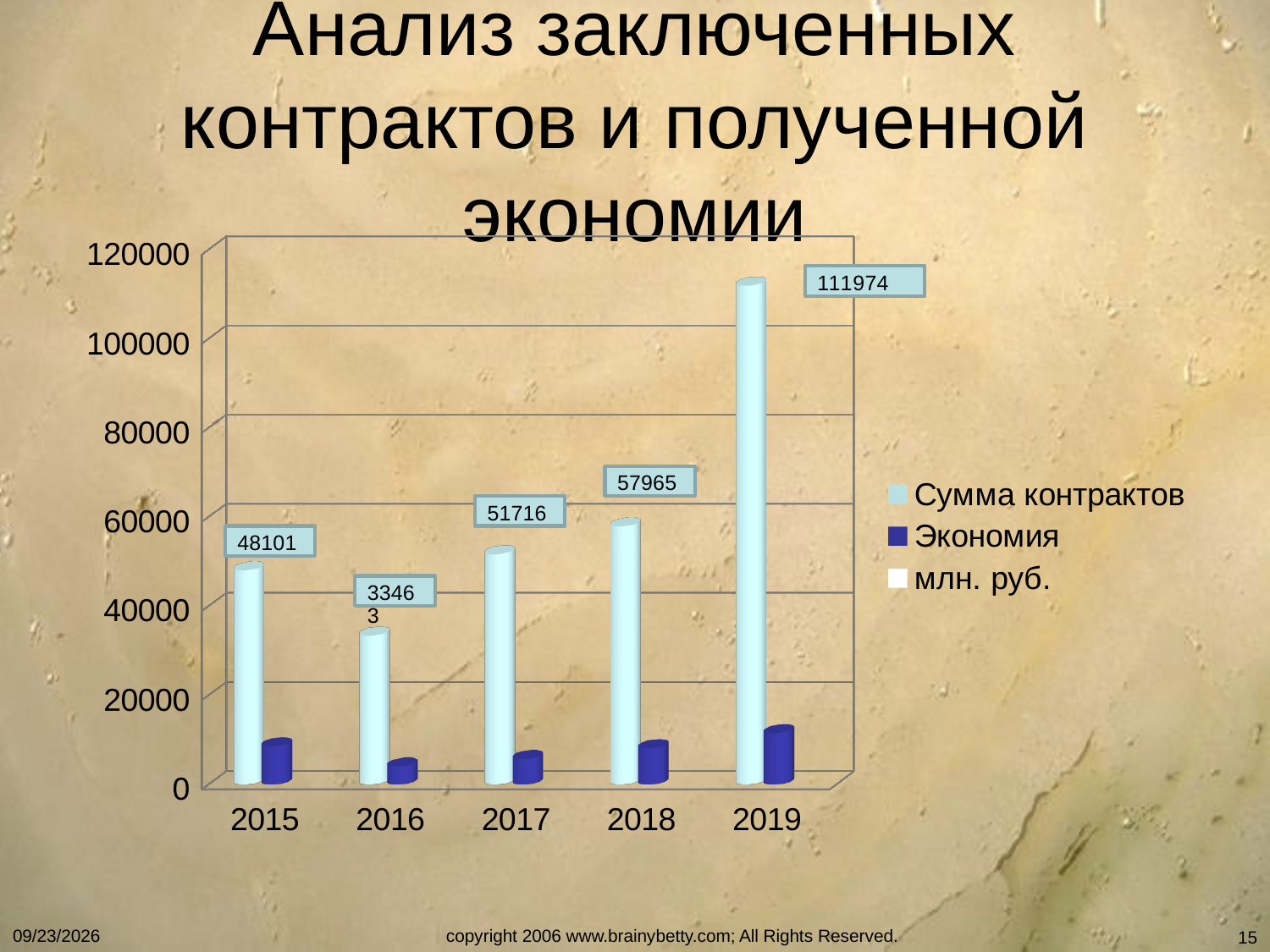
What is the value of Сумма контрактов for 2018? 57965 What is the value of Сумма контрактов for 2017? 51716 How many years are shown on the x axis? 5 What is the value of Сумма контрактов for 2015? 48101 What is the value of Сумма контрактов for 2019? 111974 What is the difference between the Сумма контрактов values for 2019 and 2018? 54009 How many entries does the legend list? 3 Which year has the lowest value of Сумма контрактов? 2016 What kind of chart is shown on the slide? bar chart Which is larger, the Сумма контрактов value for 2017 or for 2018? 2018 Is the value of Экономия for 2019 greater or less than 20000? less Which year has the highest value of Сумма контрактов? 2019